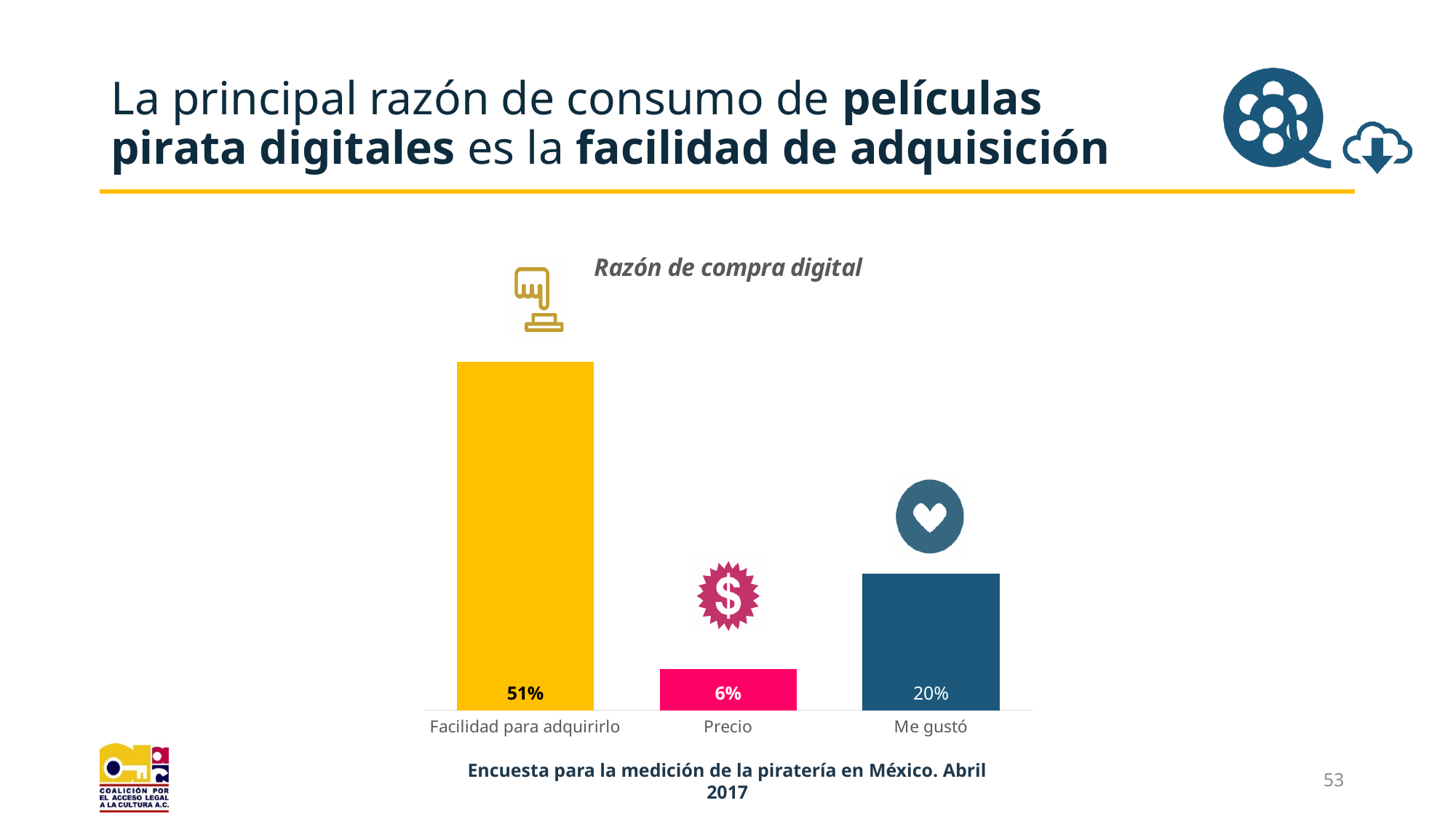
Which category has the lowest value? Precio What is the value for Me gustó? 20% What is the value for Precio? 6% Which is larger, Precio or Me gustó? Me gustó How many categories are shown in the chart? 3 What is the value for Facilidad para adquirirlo? 51% What is the title of the chart? Razón de compra digital What kind of chart is shown on the slide? Bar chart What is the difference between Me gustó and Precio? 14% Which category has the highest value? Facilidad para adquirirlo What is the difference between Facilidad para adquirirlo and Me gustó? 31% What colour is the bar for Precio? Pink